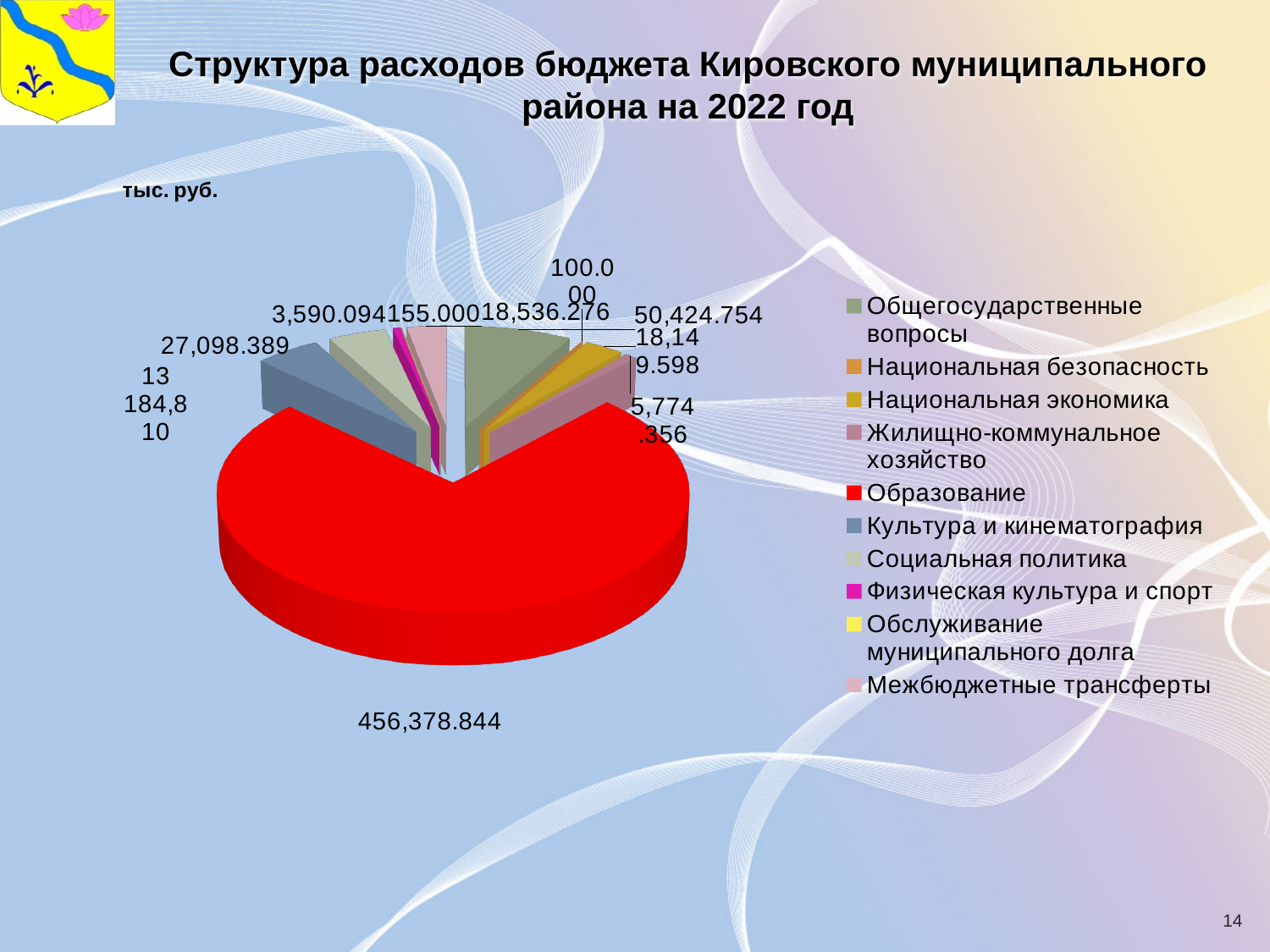
What kind of chart is shown on the slide? pie chart What is the value shown for Общегосударственные вопросы? 50,424.754 What is the title of the chart on the slide? Структура расходов бюджета Кировского муниципального района на 2022 год How many categories does the legend of the pie chart list? 10 Which is larger, the slice for Образование or the slice for Общегосударственные вопросы? Образование What is the value shown for Образование? 456,378.844 In what units are the values on the chart given? тыс. руб. Which category has the largest slice of the pie chart? Образование What colour is the slice for Образование? red